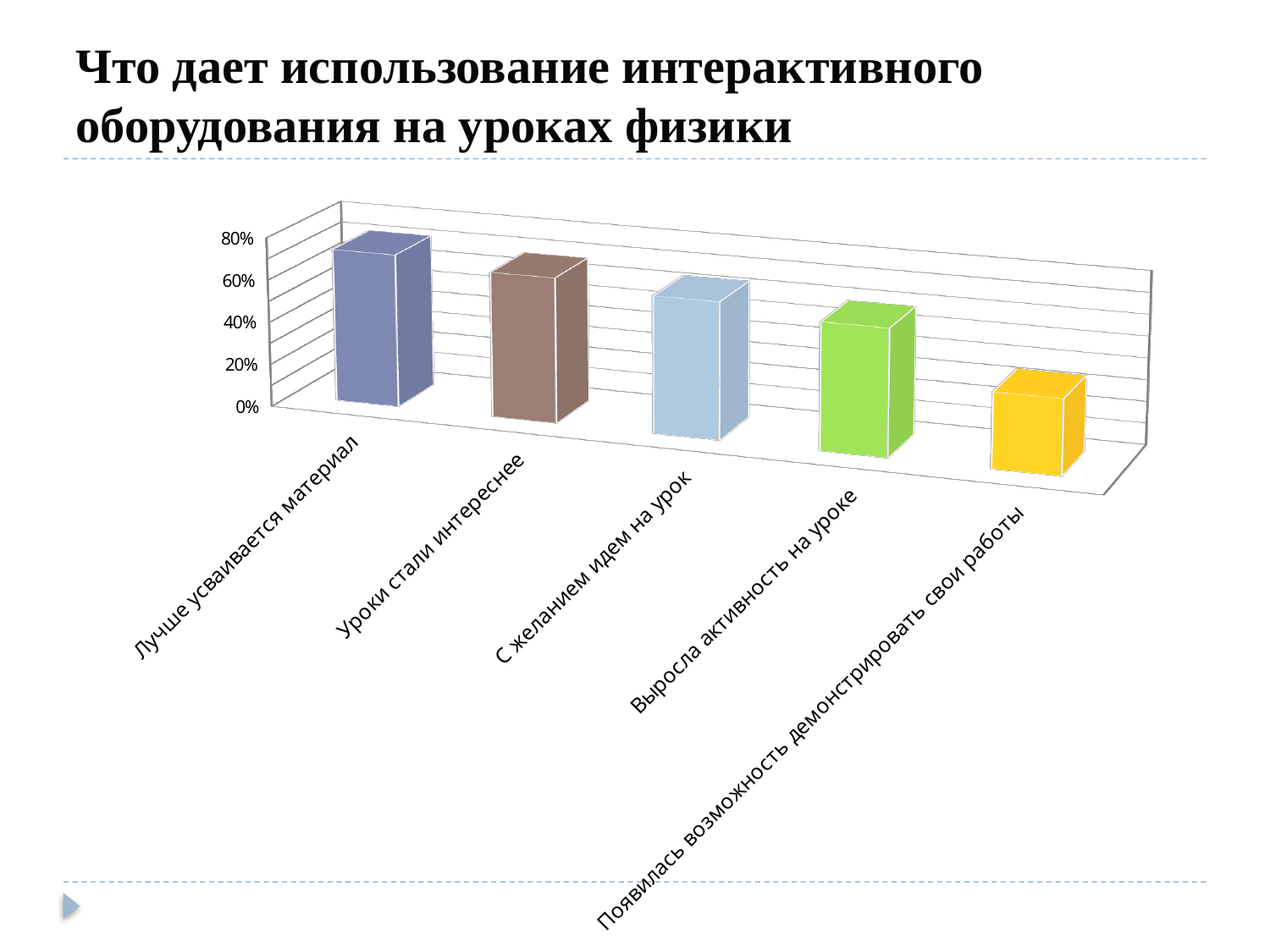
What is the title of the slide containing the chart? Что дает использование интерактивного оборудования на уроках физики What kind of chart is shown on the slide? bar chart Which is larger: the value for "С желанием идем на урок" or the value for "Появилась возможность демонстрировать свои работы"? С желанием идем на урок What is the highest value shown on the vertical axis of the chart? 80% Is the value for "Выросла активность на уроке" greater or less than 20%? greater Do the bar values rise or fall from left to right along the x axis? fall How many categories are plotted in the chart? 5 Which is larger: the value for "Уроки стали интереснее" or the value for "Выросла активность на уроке"? Уроки стали интереснее Is the value for "Лучше усваивается материал" greater or less than 40%? greater Which category has the lowest bar? Появилась возможность демонстрировать свои работы Which category has the highest bar? Лучше усваивается материал